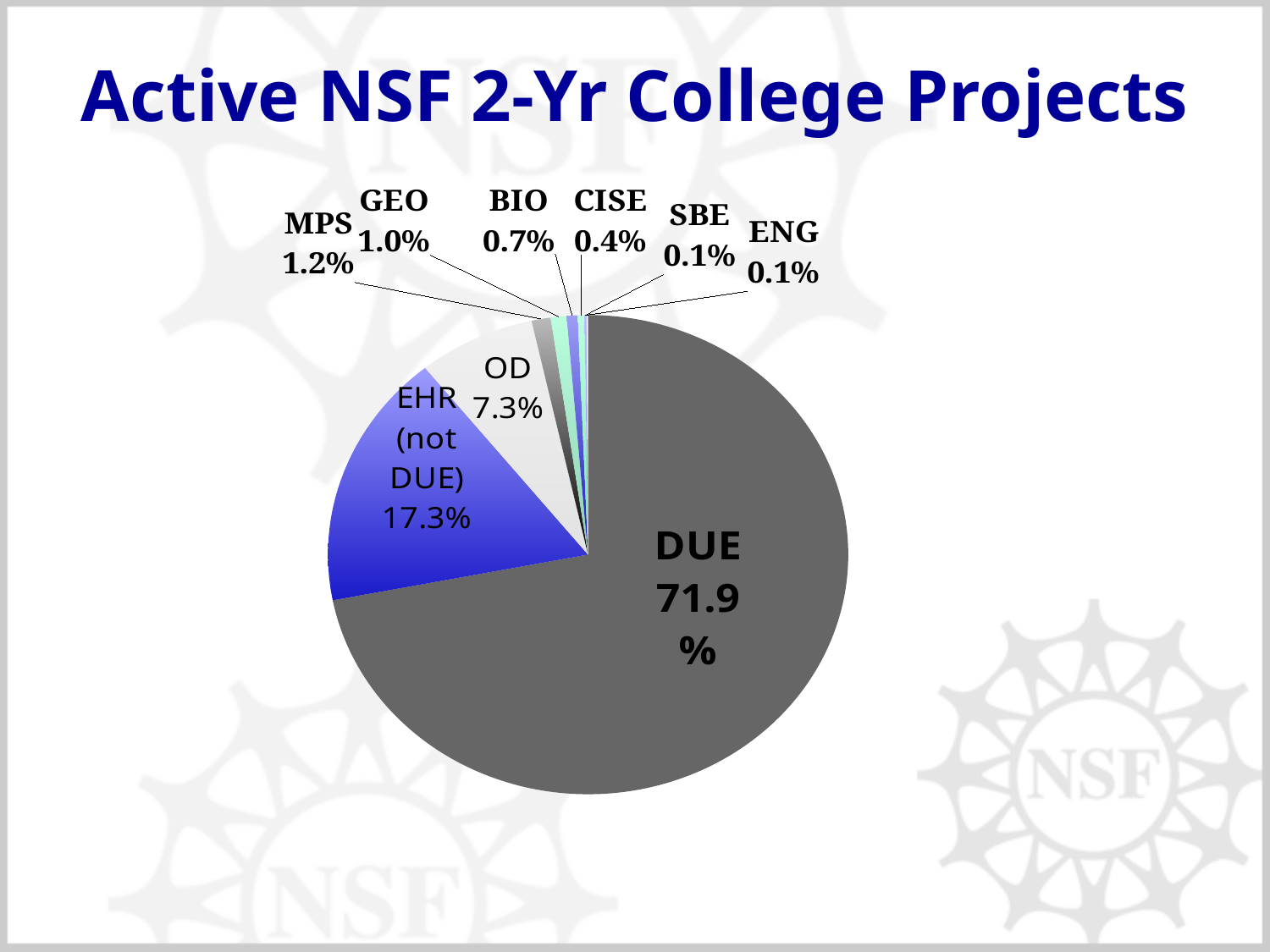
What kind of chart is shown on the slide? pie chart What is the value for EHR (not DUE)? 17.3% How many categories are shown in the pie chart? 9 Which is larger, the share for OD or the share for MPS? OD What is the difference between the DUE and EHR (not DUE) shares? 54.6% What is the value for OD? 7.3% What is the title of the chart? Active NSF 2-Yr College Projects What is the value for GEO? 1.0% Which category has the largest slice of the pie? DUE What is the value for MPS? 1.2% What is the value for BIO? 0.7% What share of the pie does DUE account for? 71.9%